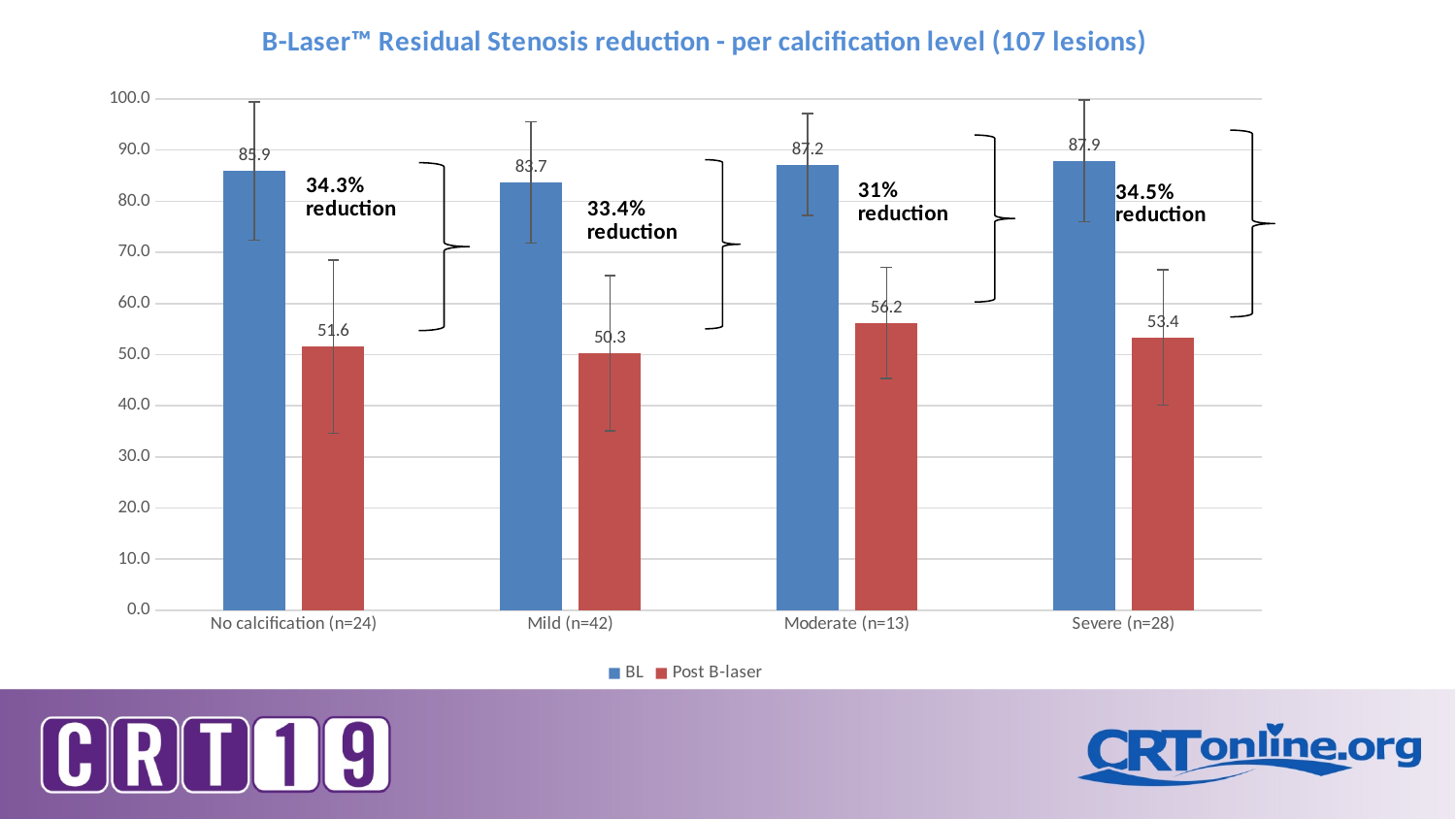
What is the Post B-laser value for Moderate (n=13)? 56.2 Which category has the highest BL value? Severe (n=28) How many categories are shown on the x axis? 4 What percentage reduction is annotated for Moderate (n=13)? 31% reduction How many series does the legend list? 2 What kind of chart is shown on the slide? Bar chart What is the Post B-laser value for No calcification (n=24)? 51.6 What is the BL value for Mild (n=42)? 83.7 Which category has the lowest Post B-laser value? Mild (n=42) What is the title of the chart? B-Laser™ Residual Stenosis reduction - per calcification level (107 lesions) Which is larger, the Post B-laser value for Moderate (n=13) or for Severe (n=28)? Moderate (n=13) What is the difference between the BL and Post B-laser values for Severe (n=28)? 34.5